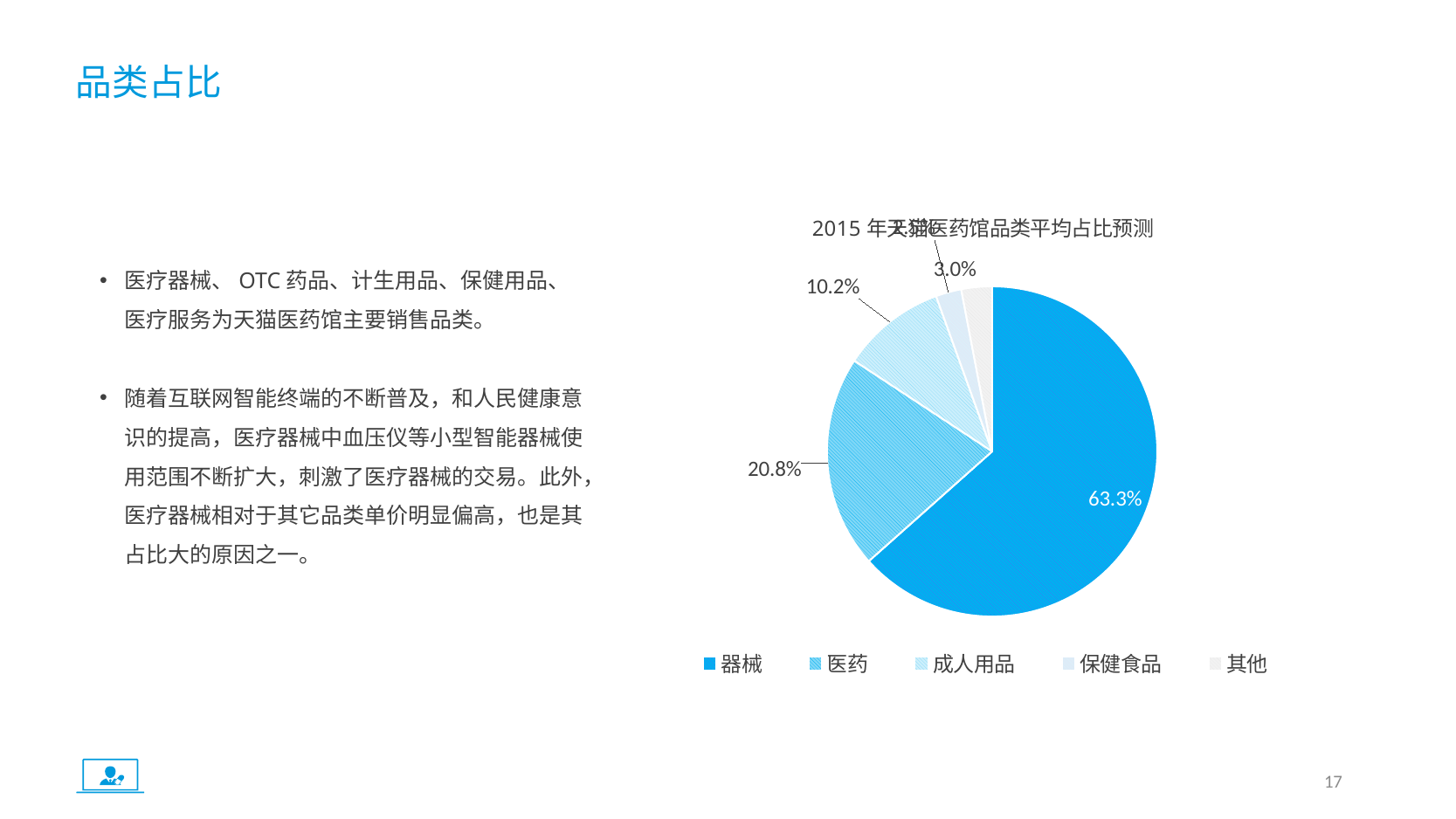
What is the difference between the share for 医药 and the share for 成人用品? 10.6 percentage points How many categories does the legend list? 5 What kind of chart is shown on the slide? Pie chart Which is larger, the share for 医药 or the share for 成人用品? 医药 What share of the pie does 器械 account for? 63.3% What is the title of the pie chart? 2015 年天猫医药馆品类平均占比预测 Which category has the largest slice of the pie? 器械 Which legend entry is listed first, at the far left of the legend? 器械 Is the share for 器械 greater or less than 50%? greater What is the value shown for 成人用品? 10.2% What is the difference between the share for 器械 and the share for 医药? 42.5 percentage points What is the value shown for 医药? 20.8%